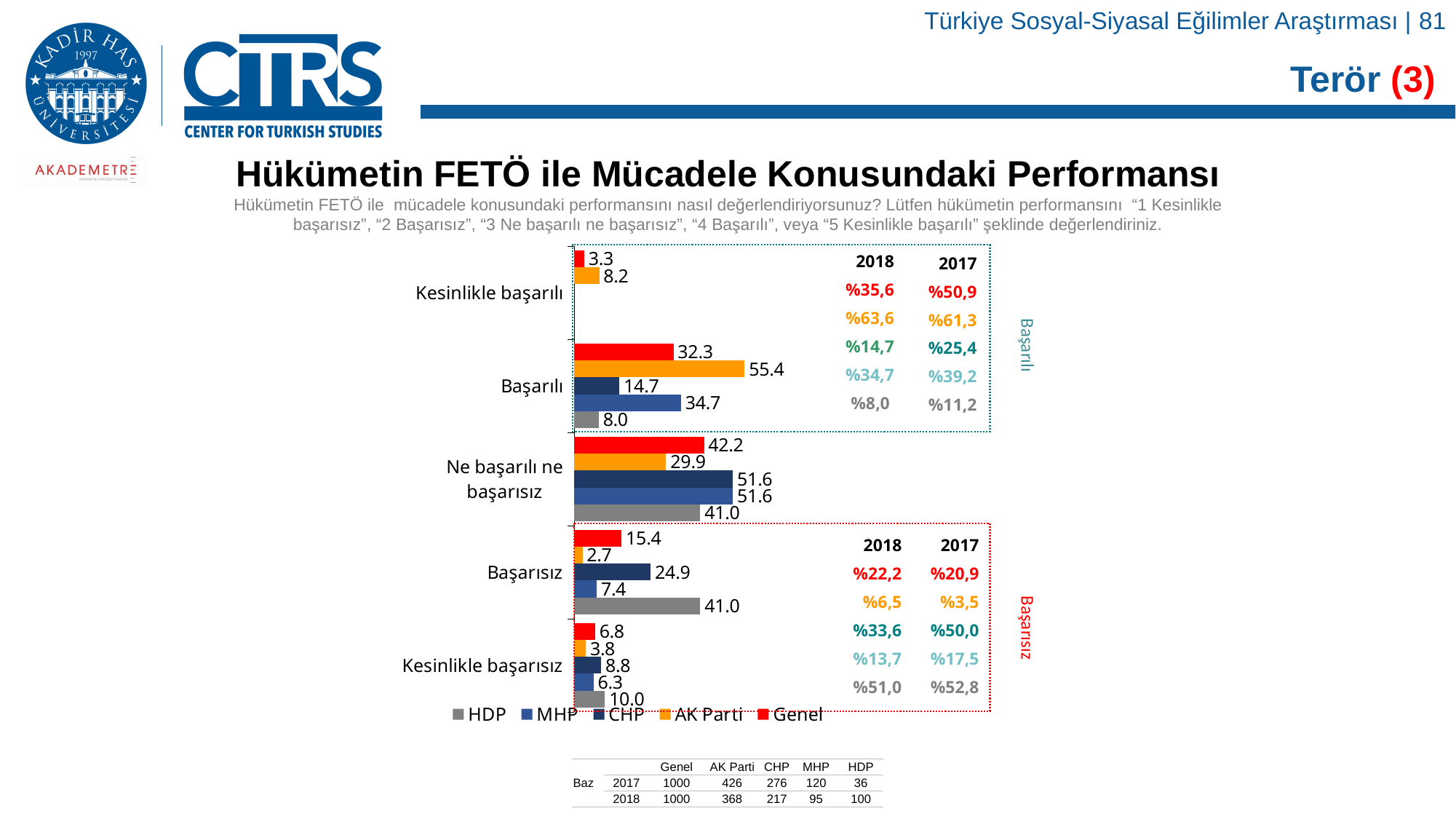
In the "Kesinlikle başarısız" category, which is larger: the HDP value or the CHP value? HDP What is the value for HDP in the "Başarısız" category? 41.0 What type of chart is shown on the slide? Bar chart Which series has the lowest value in the "Başarısız" category? AK Parti Which series has the highest value in the "Başarılı" category? AK Parti What is the difference between the Genel and CHP values in the "Başarılı" category? 17.6 Which series has the highest value in the "Kesinlikle başarısız" category? HDP What is the difference between the Genel and AK Parti values in the "Ne başarılı ne başarısız" category? 12.3 How many categories are shown on the chart's vertical axis? 5 What is the value for Genel in the "Kesinlikle başarılı" category? 3.3 What is the value for AK Parti in the "Başarılı" category? 55.4 How many series does the chart legend list? 5